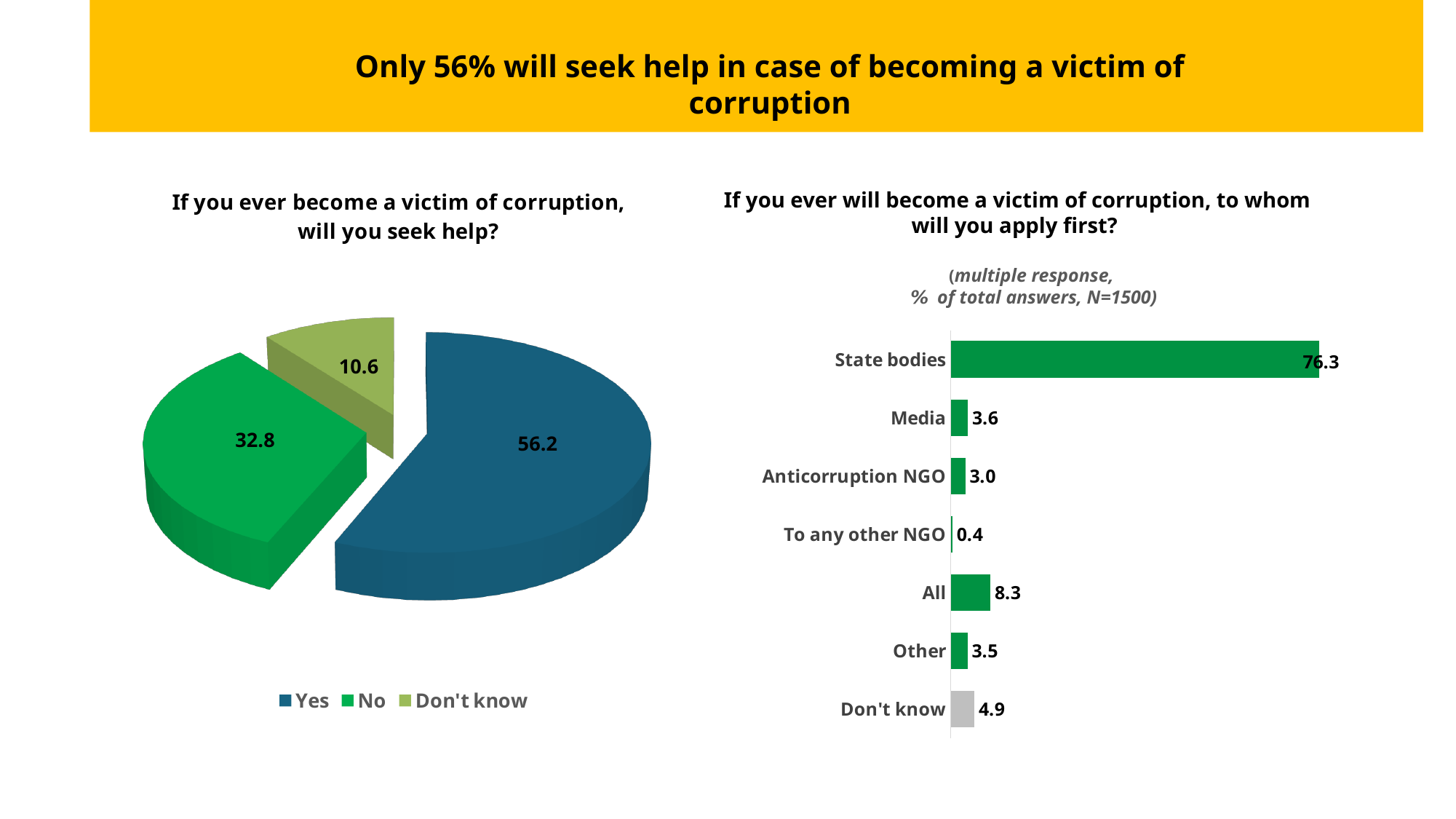
In the bar chart on the right, which category has the highest value? State bodies In the bar chart on the right, which is larger: the value for "All" or the value for "Don't know"? All What kind of chart is the chart on the left? Pie chart In the pie chart on the left, how many entries does the legend list? 3 In the pie chart on the left, which category has the smallest slice? Don't know In the bar chart on the right, what is the value for "To any other NGO"? 0.4 In the bar chart on the right, what is the value for "State bodies"? 76.3 In the pie chart on the left, what is the value for "Don't know"? 10.6 In the pie chart on the left, what is the difference between the "Yes" and "No" values? 23.4 In the bar chart on the right, which category has the lowest value? To any other NGO How many categories are shown in the bar chart on the right? 7 In the pie chart on the left, what is the value for "Yes"? 56.2